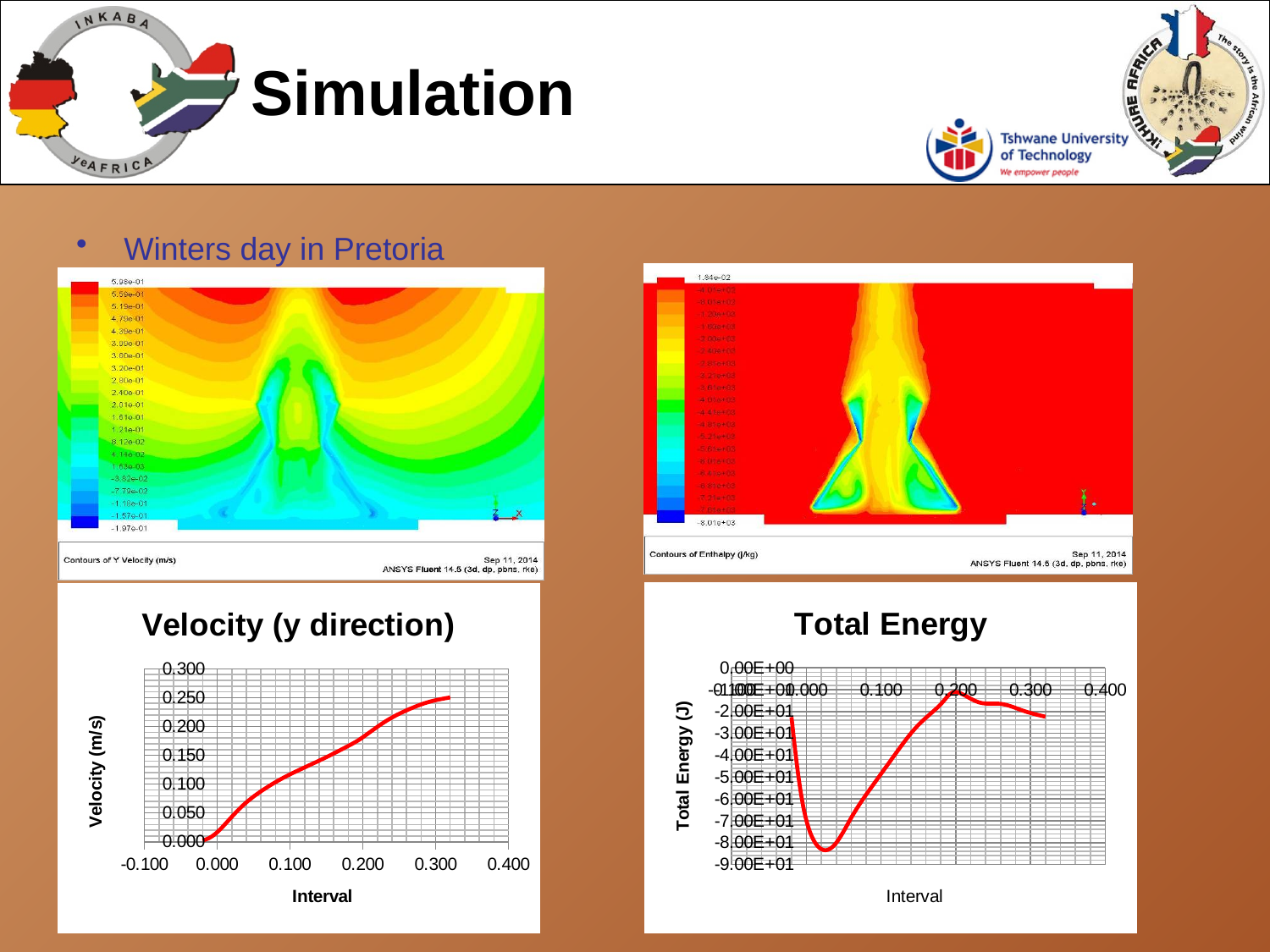
What kind of chart is the "Total Energy" chart? line chart In the "Total Energy" chart, is the value at interval 0.050 greater or less than -6.00E+01? less In the "Total Energy" chart, which is larger: the value at interval 0.200 or at interval 0.050? interval 0.200 In the "Velocity (y direction)" chart, which is larger: the velocity at interval 0.200 or at interval 0.100? interval 0.200 What is the x-axis title of the "Total Energy" chart? Interval In the "Total Energy" chart, is the lowest value of the line greater or less than -7.00E+01? less In the "Velocity (y direction)" chart, do the values rise or fall as the interval increases? rise In the "Velocity (y direction)" chart, is the velocity at interval 0.300 greater or less than 0.200? greater What kind of chart is the "Velocity (y direction)" chart? line chart What is the y-axis title of the "Velocity (y direction)" chart? Velocity (m/s)